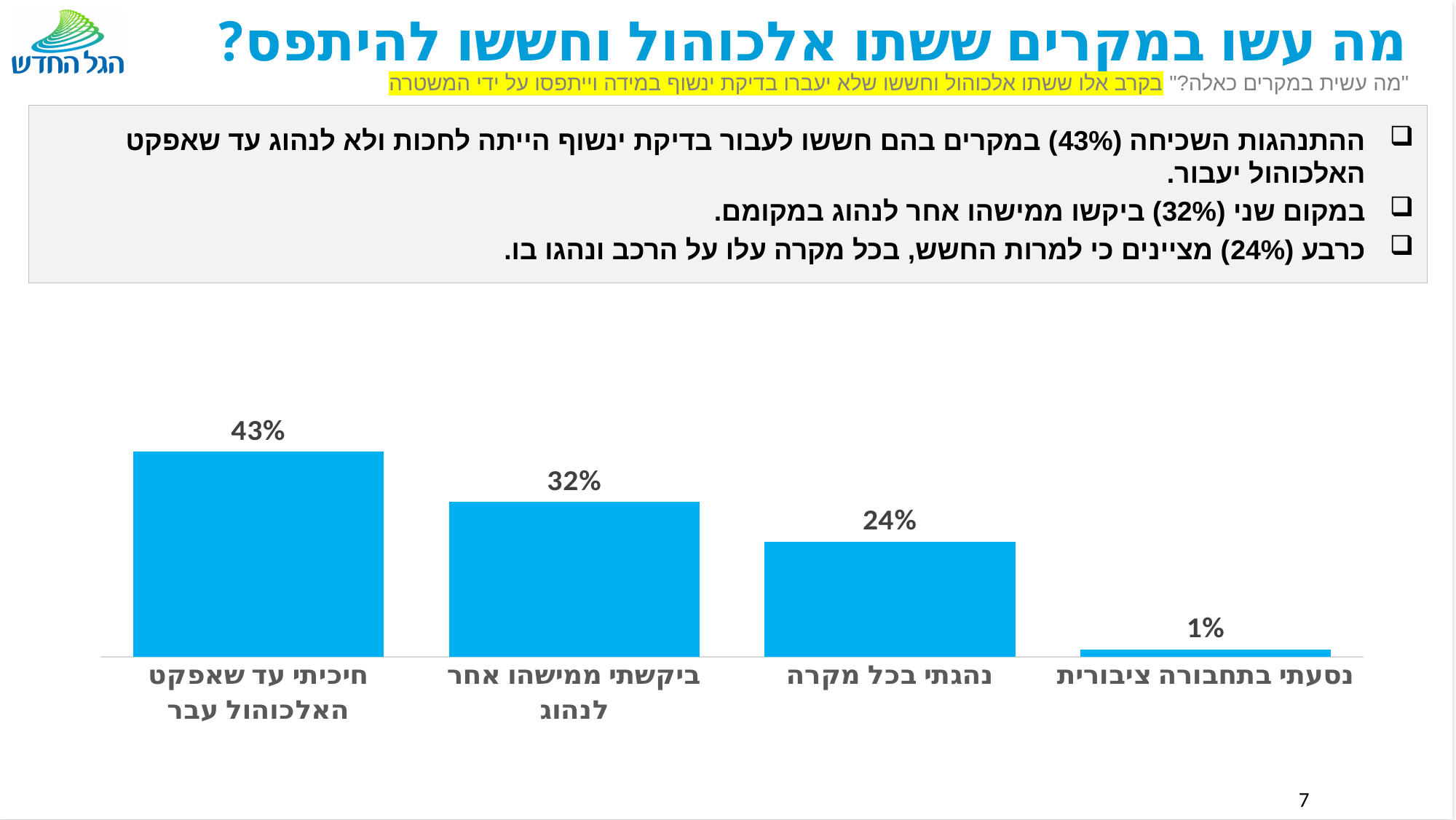
What is the value for the category "נהגתי בכל מקרה"? 24% What is the difference between the values for "נהגתי בכל מקרה" and "נסעתי בתחבורה ציבורית"? 23% What is the value for the category "נסעתי בתחבורה ציבורית"? 1% Which category has the lowest value? נסעתי בתחבורה ציבורית Which is larger: the value for "ביקשתי ממישהו אחר לנהוג" or the value for "נהגתי בכל מקרה"? ביקשתי ממישהו אחר לנהוג What colour are the bars in the chart? Blue What kind of chart is shown on the slide? Bar chart What is the difference between the values for "חיכיתי עד שאפקט האלכוהול עבר" and "ביקשתי ממישהו אחר לנהוג"? 11% What is the value for the category "חיכיתי עד שאפקט האלכוהול עבר"? 43% Which category has the highest value? חיכיתי עד שאפקט האלכוהול עבר How many categories are shown in the chart? 4 What is the value for the category "ביקשתי ממישהו אחר לנהוג"? 32%